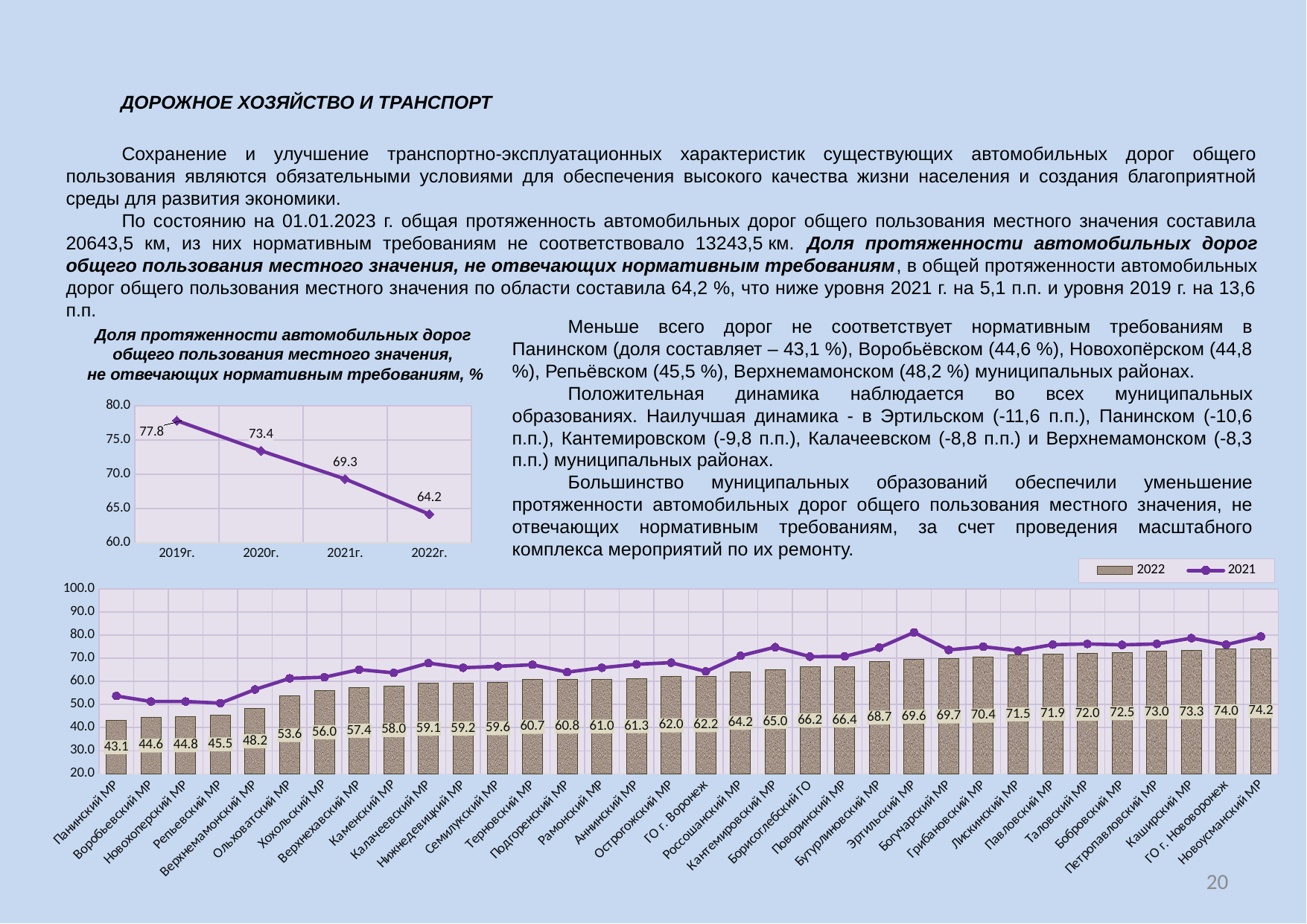
In the bottom bar chart, which category has the highest 2022 value? Новоусманский МР In the bottom bar chart, what is the 2022 value for Эртильский МР? 69.6 In the top-left line chart, do the values rise or fall from 2019г. to 2022г.? fall In the bottom bar chart, is the 2021 value for Эртильский МР greater or less than 80.0? greater In the top-left line chart, what is the value for 2022г.? 64.2 In the top-left line chart, what is the difference between the 2019г. and 2022г. values? 13.6 In the bottom bar chart, which is larger for 2022: Хохольский МР or Каменский МР? Каменский МР In the bottom bar chart, how many series does the legend list? 2 In the top-left line chart, what is the value for 2019г.? 77.8 In the bottom bar chart, what is the 2022 value for Панинский МР? 43.1 In the bottom bar chart, which category has the lowest 2022 value? Панинский МР In the top-left line chart, how many data points are plotted? 4